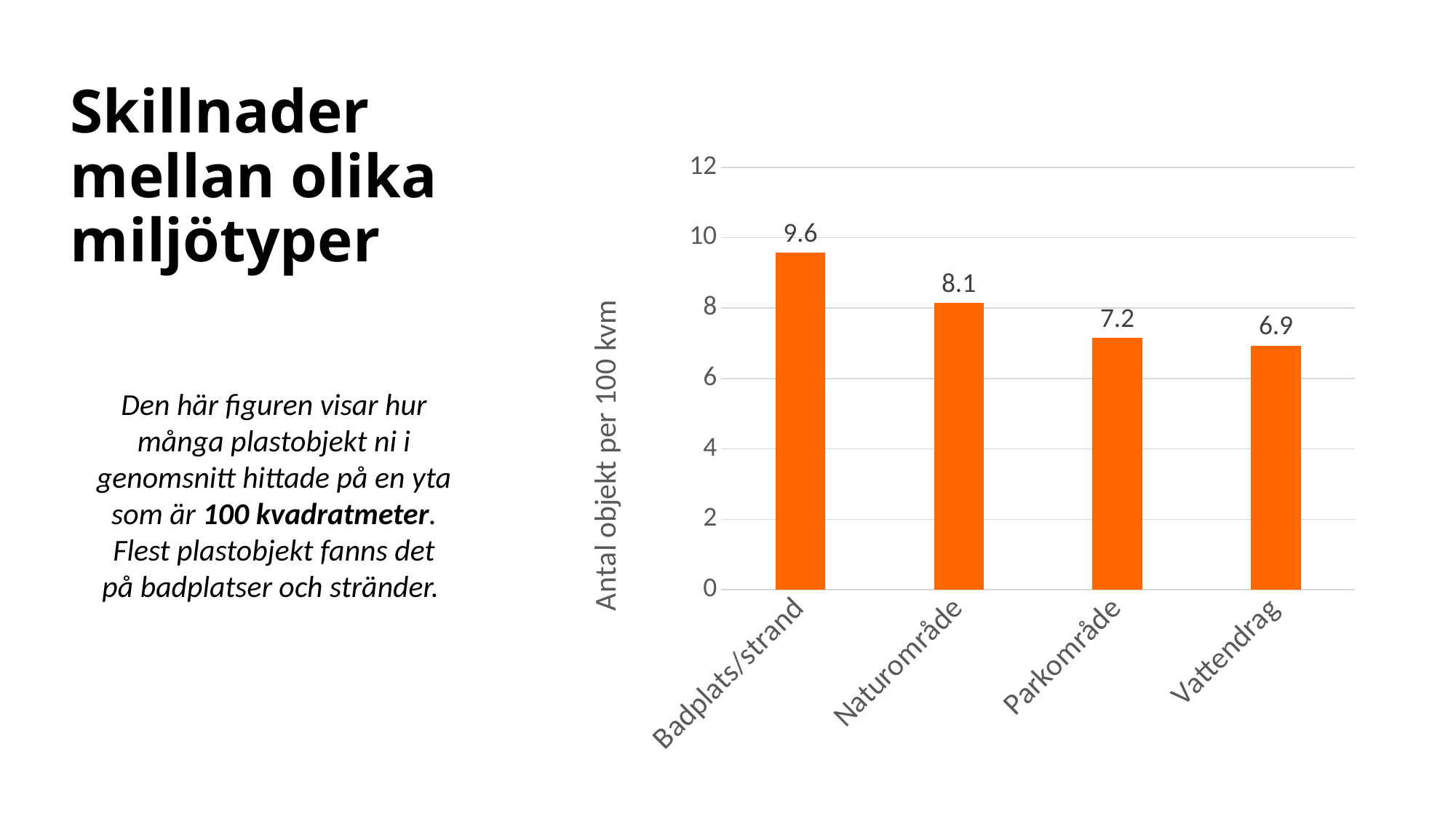
Which is larger, the value for Naturområde or the value for Parkområde? Naturområde Which category has the lowest value? Vattendrag What is the difference between the values for Naturområde and Parkområde? 0.9 What kind of chart is shown on the slide? Bar chart What is the value for Badplats/strand? 9.6 What is the label of the vertical axis? Antal objekt per 100 kvm How many categories are shown on the x axis? 4 What is the value for Vattendrag? 6.9 What is the value for Naturområde? 8.1 Which category has the highest value? Badplats/strand What is the value for Parkområde? 7.2 What is the difference between the values for Badplats/strand and Vattendrag? 2.7